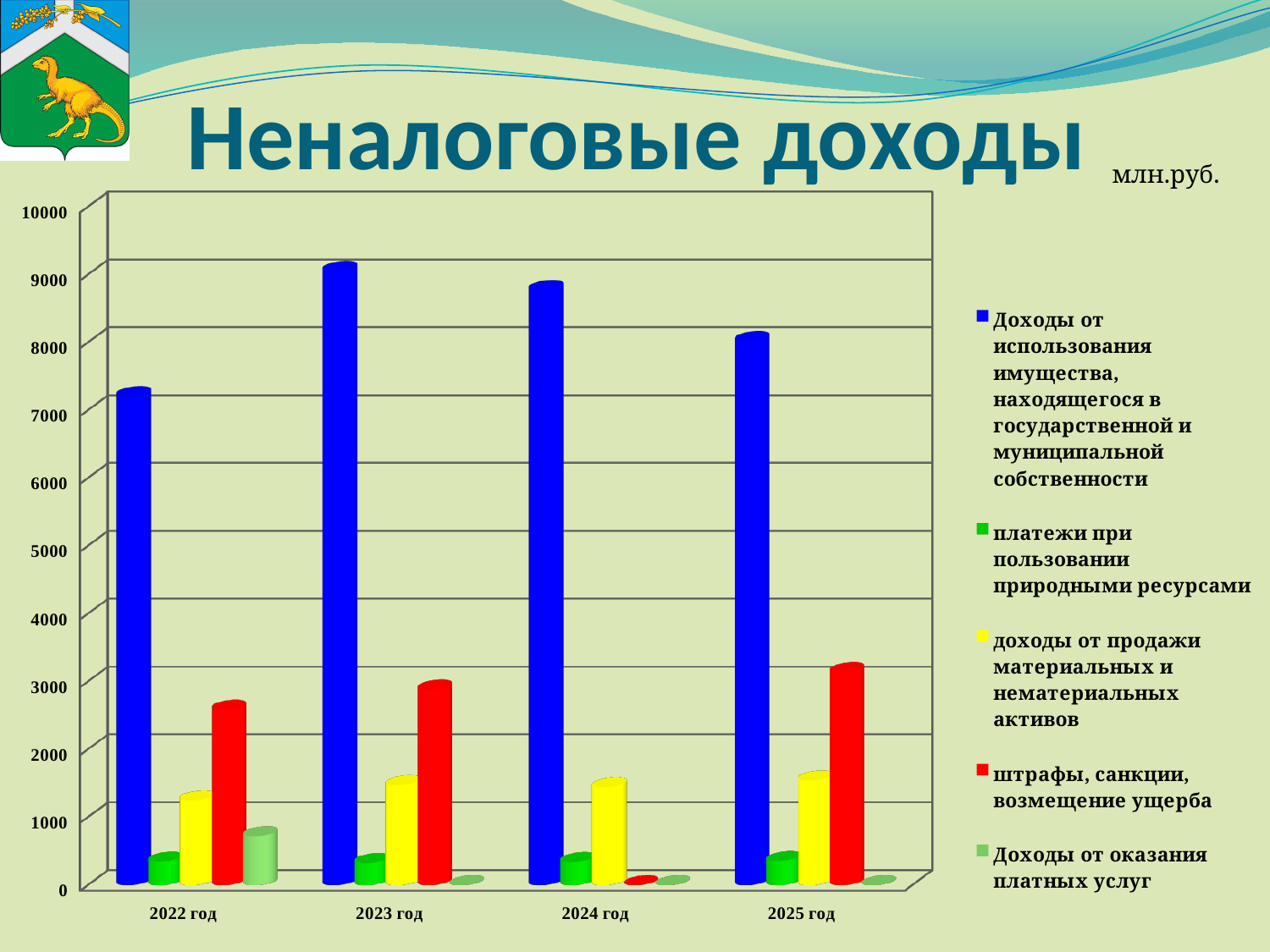
Is the value for 'Доходы от использования имущества' in 2022 год greater or less than 8000? less How many series does the legend of the chart list? 5 What kind of chart is shown on the slide? bar chart How many years (categories) are shown on the x axis of the chart? 4 Which series has the tallest bar in 2025 год? Доходы от использования имущества, находящегося в государственной и муниципальной собственности In which year is the bar for 'Доходы от использования имущества, находящегося в государственной и муниципальной собственности' the highest? 2023 год Is the value for 'Доходы от использования имущества' in 2023 год greater or less than 8000? greater Which is larger: the value for 'штрафы, санкции, возмещение ущерба' in 2025 год or in 2022 год? 2025 год In what units are the values on the chart given? млн.руб. In which year is the bar for 'Доходы от использования имущества, находящегося в государственной и муниципальной собственности' the lowest? 2022 год What is the title of the chart? Неналоговые доходы Is the value for 'штрафы, санкции, возмещение ущерба' in 2022 год greater or less than 3000? less